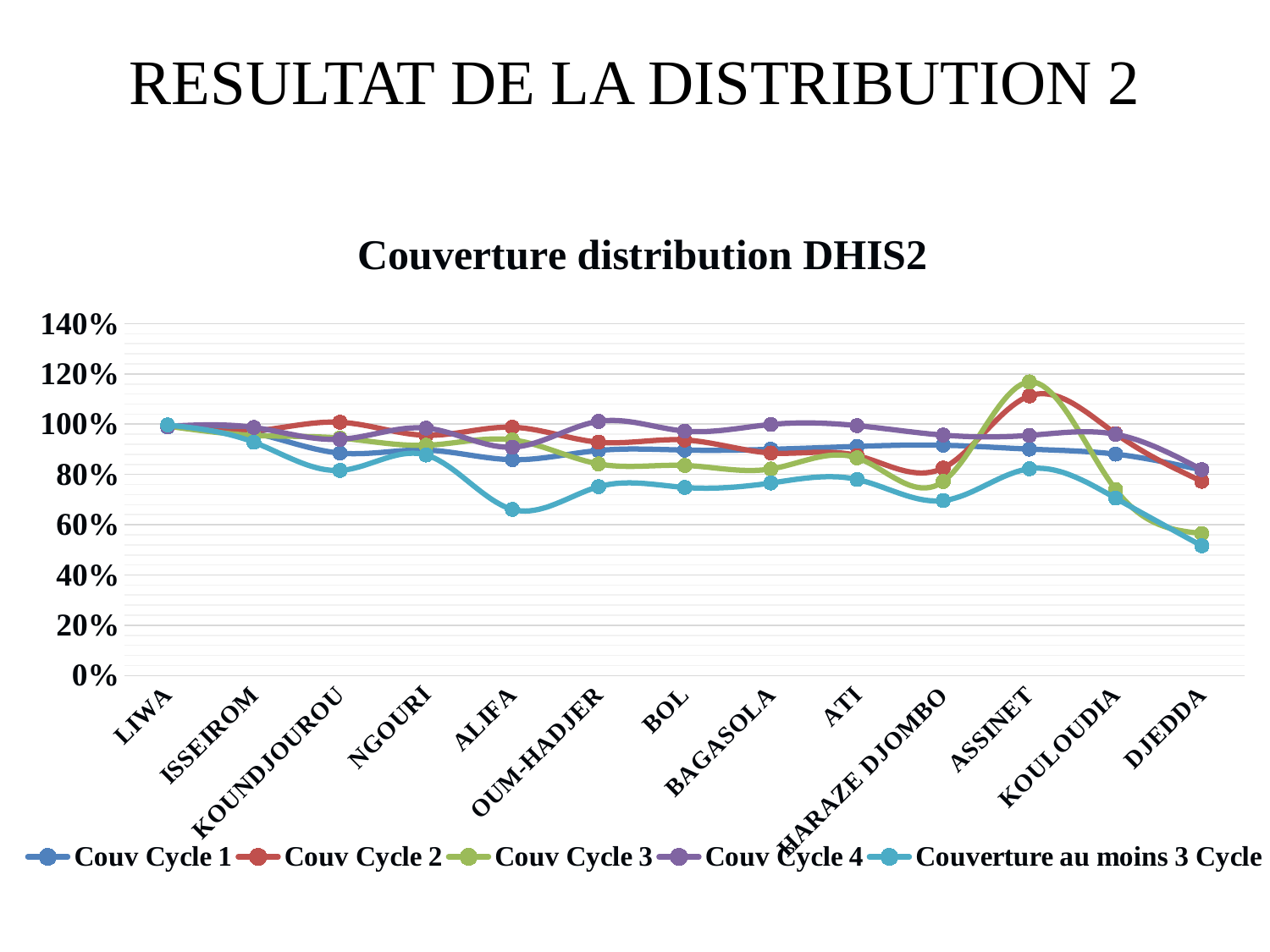
Does Couverture au moins 3 Cycle rise or fall from ASSINET to DJEDDA? fall For which category does Couverture au moins 3 Cycle reach its lowest value? DJEDDA What is the title of the chart? Couverture distribution DHIS2 How many categories are shown on the x axis? 13 For which category does Couv Cycle 3 reach its highest value? ASSINET Is the value of Couv Cycle 2 for ASSINET greater or less than 100%? greater How many series does the legend list? 5 What kind of chart is shown on the slide? Line chart Is the value of Couv Cycle 3 for ASSINET greater or less than 100%? greater At ALIFA, which is larger: Couv Cycle 2 or Couverture au moins 3 Cycle? Couv Cycle 2 Is the value of Couverture au moins 3 Cycle for DJEDDA greater or less than 60%? less